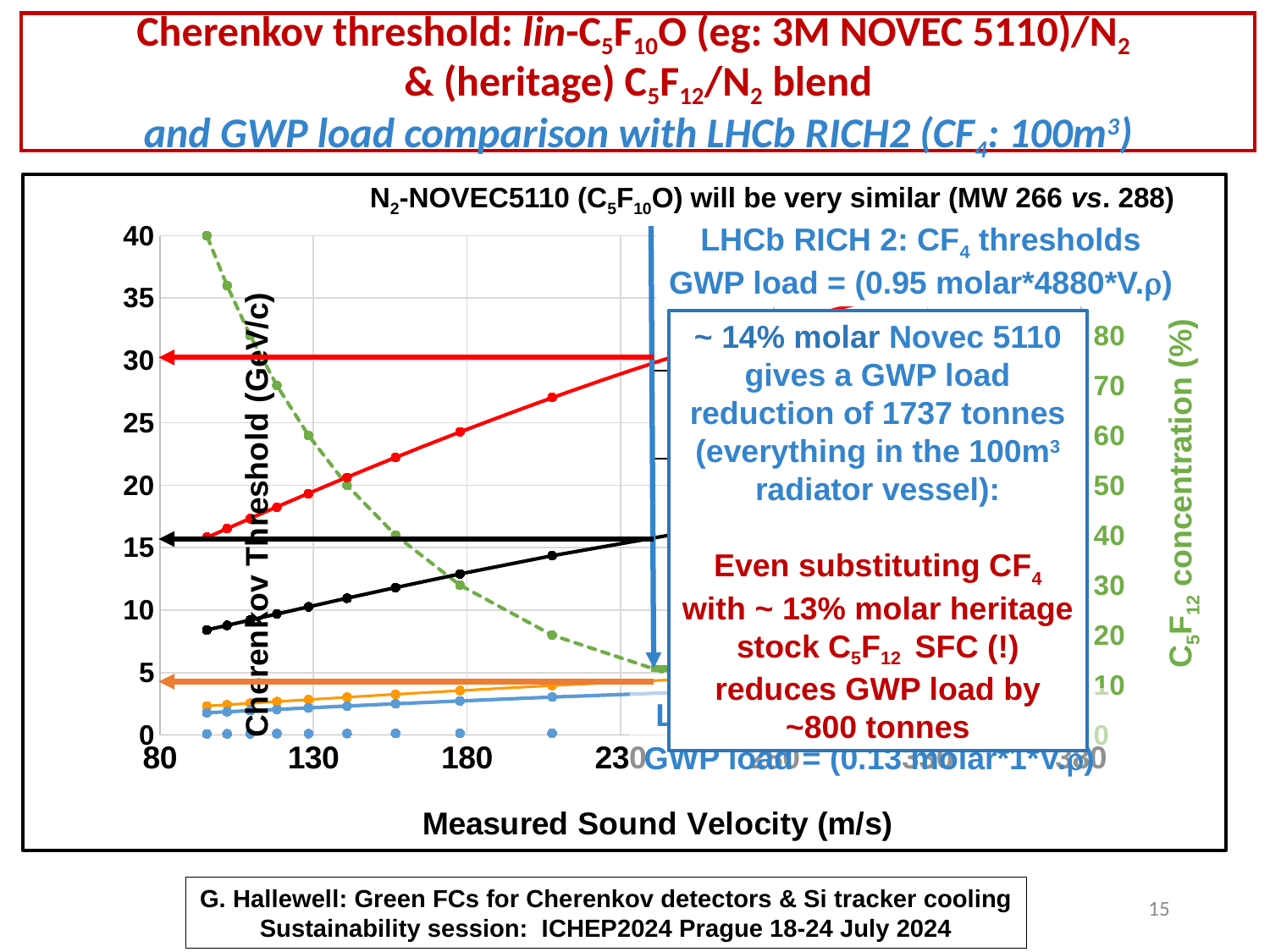
At a sound velocity of 130 m/s, which line shows the higher Cherenkov threshold, the black line or the orange line? black line What is the title of the left-hand y axis of the chart? Cherenkov Threshold (GeV/c) What is the title of the x axis of the chart? Measured Sound Velocity (m/s) Does the red line rise or fall as the measured sound velocity increases? rises Is the Cherenkov threshold on the red line at a sound velocity of 130 m/s greater or less than 15 GeV/c? greater What kind of chart is shown on the slide? line chart Is the Cherenkov threshold on the black line at a sound velocity of 230 m/s greater or less than 10 GeV/c? greater Is the Cherenkov threshold on the black line at a sound velocity of 130 m/s greater or less than 15 GeV/c? less Does the black line rise or fall as the measured sound velocity increases? rises Does the green dashed line rise or fall as the measured sound velocity increases? falls At a sound velocity of 180 m/s, which line shows the higher Cherenkov threshold, the red line or the black line? red line